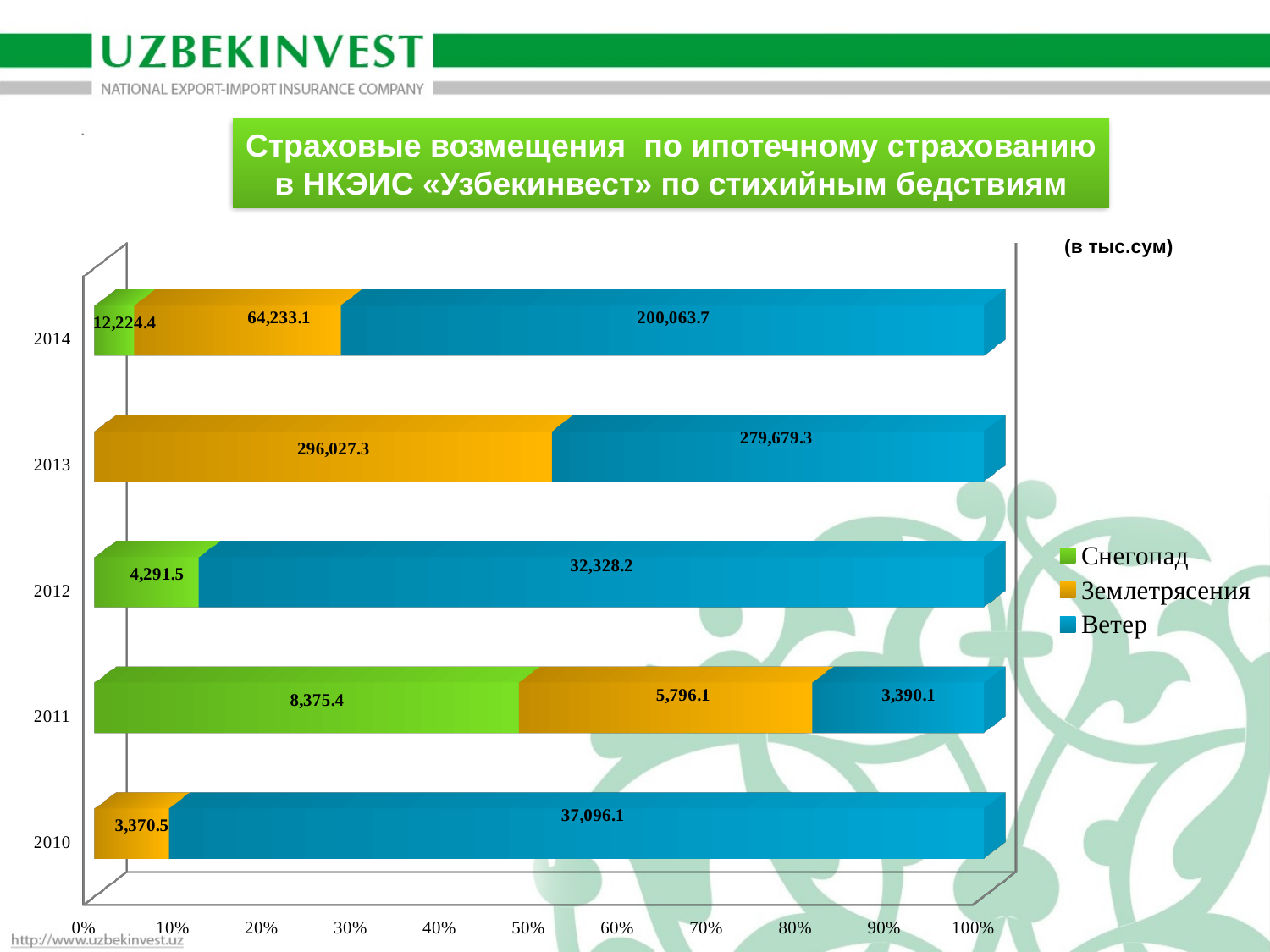
How many series does the legend list? 3 In which year is the Ветер value the highest? 2013 What is the difference between Ветер and Землетрясения in 2014? 135,830.6 What is the value for Снегопад in 2011? 8,375.4 What is the total of the three values for 2011? 17,561.6 What is the value for Землетрясения in 2010? 3,370.5 How many years are shown on the chart? 5 What is the value for Землетрясения in 2013? 296,027.3 What type of chart is shown on the slide? Stacked bar chart Which is larger in 2013, Землетрясения or Ветер? Землетрясения What is the value for Ветер in 2014? 200,063.7 In what units are the values given, according to the note at the top right of the chart? в тыс.сум